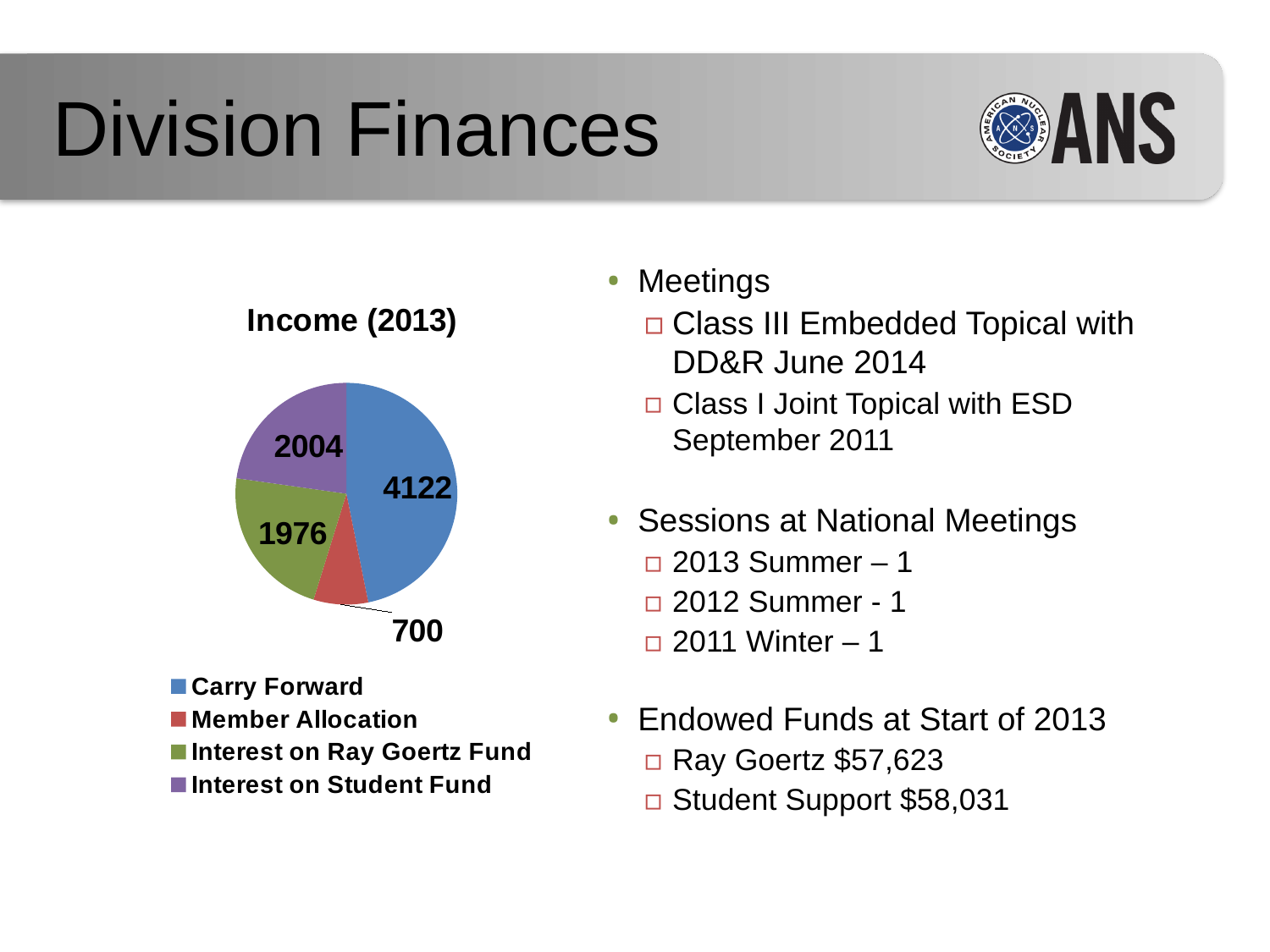
Which category has the smallest slice in the Income (2013) pie chart? Member Allocation Which is larger, Interest on Student Fund or Interest on Ray Goertz Fund? Interest on Student Fund What is the value for Carry Forward in the Income (2013) pie chart? 4122 Which colour represents Interest on Ray Goertz Fund in the legend? green What is the title of the chart? Income (2013) What is the value for Interest on Ray Goertz Fund in the Income (2013) pie chart? 1976 What type of chart is shown on the slide? pie chart Which category has the largest slice in the Income (2013) pie chart? Carry Forward What is the value for Member Allocation in the Income (2013) pie chart? 700 What is the value for Interest on Student Fund in the Income (2013) pie chart? 2004 What is the difference between the Carry Forward value and the Member Allocation value? 3422 How many categories does the Income (2013) pie chart show? 4